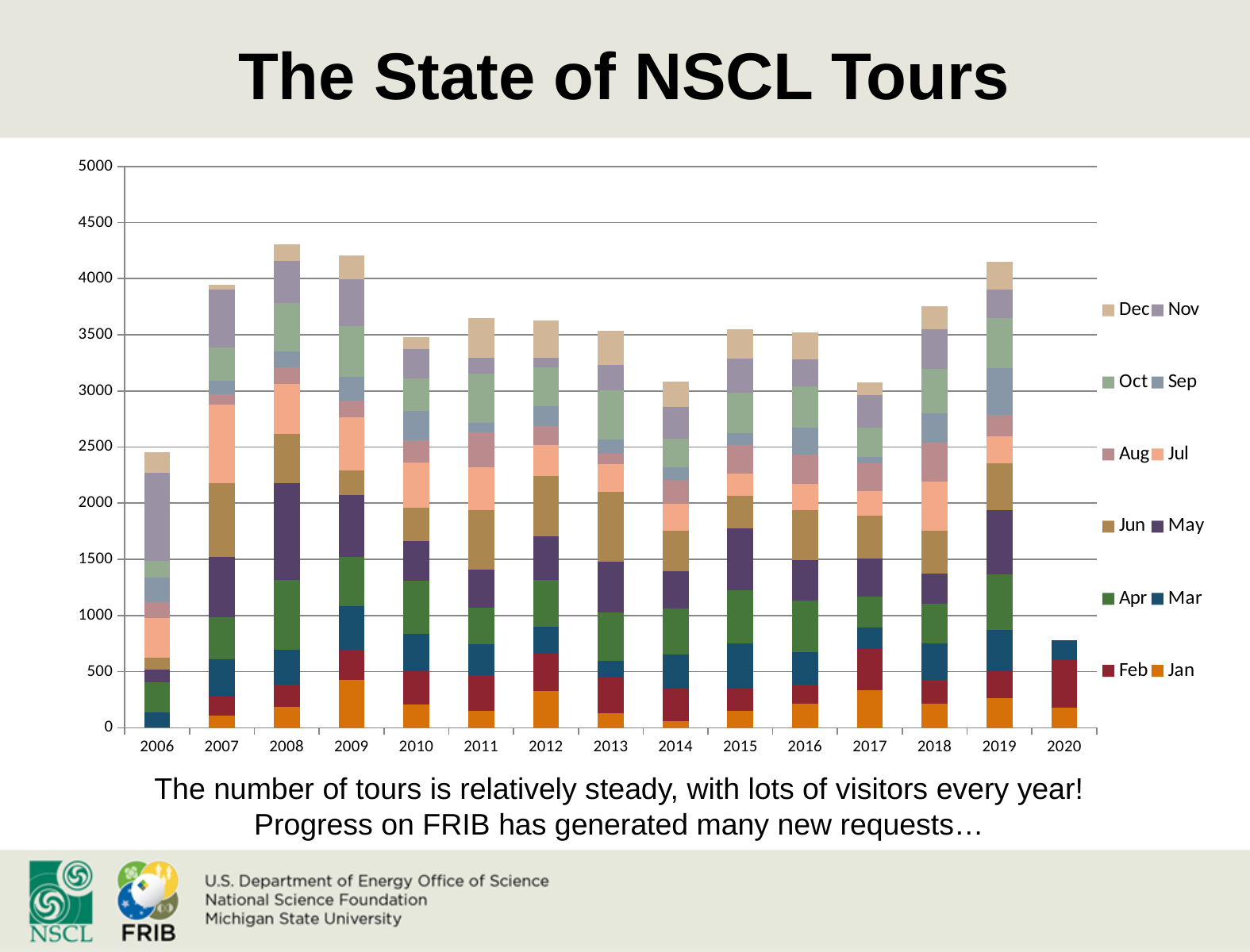
Which year has the larger total bar, 2018 or 2017? 2018 How many series does the chart's legend list? 12 Is the total for 2020 greater or less than 1000? less Which year has the larger total bar, 2006 or 2020? 2006 What is the title of the slide containing the chart? The State of NSCL Tours How many years are shown along the x axis of the chart? 15 Is the total for 2006 greater or less than 3000? less Is the total for 2019 greater or less than 4000? greater Which year has the lowest total bar in the chart? 2020 What kind of chart is shown on the slide? Stacked bar chart